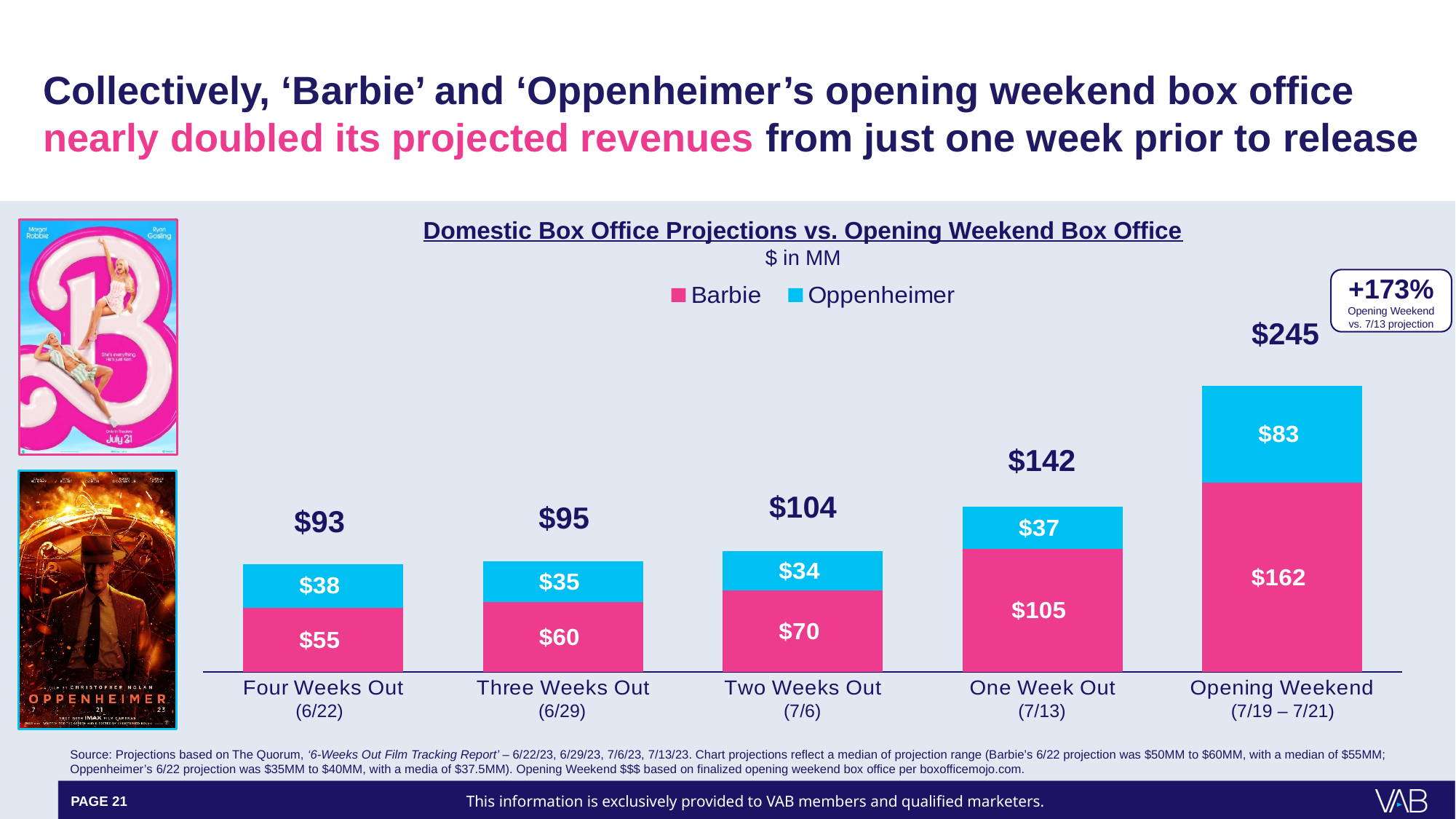
Which is larger, the Oppenheimer value for Four Weeks Out or for Three Weeks Out? Four Weeks Out What kind of chart is shown? Stacked bar chart What is the Oppenheimer value for Two Weeks Out? $34 Do the total values rise or fall from Four Weeks Out to Opening Weekend? Rise How many series does the legend list? 2 What is the title of the chart? Domestic Box Office Projections vs. Opening Weekend Box Office What is the difference between the Barbie values for Opening Weekend and One Week Out? $57 Which category has the highest total? Opening Weekend How many categories are shown on the x axis? 5 What is the total of the stacked bar for One Week Out? $142 Which category has the lowest total? Four Weeks Out What is the Barbie value for Opening Weekend? $162